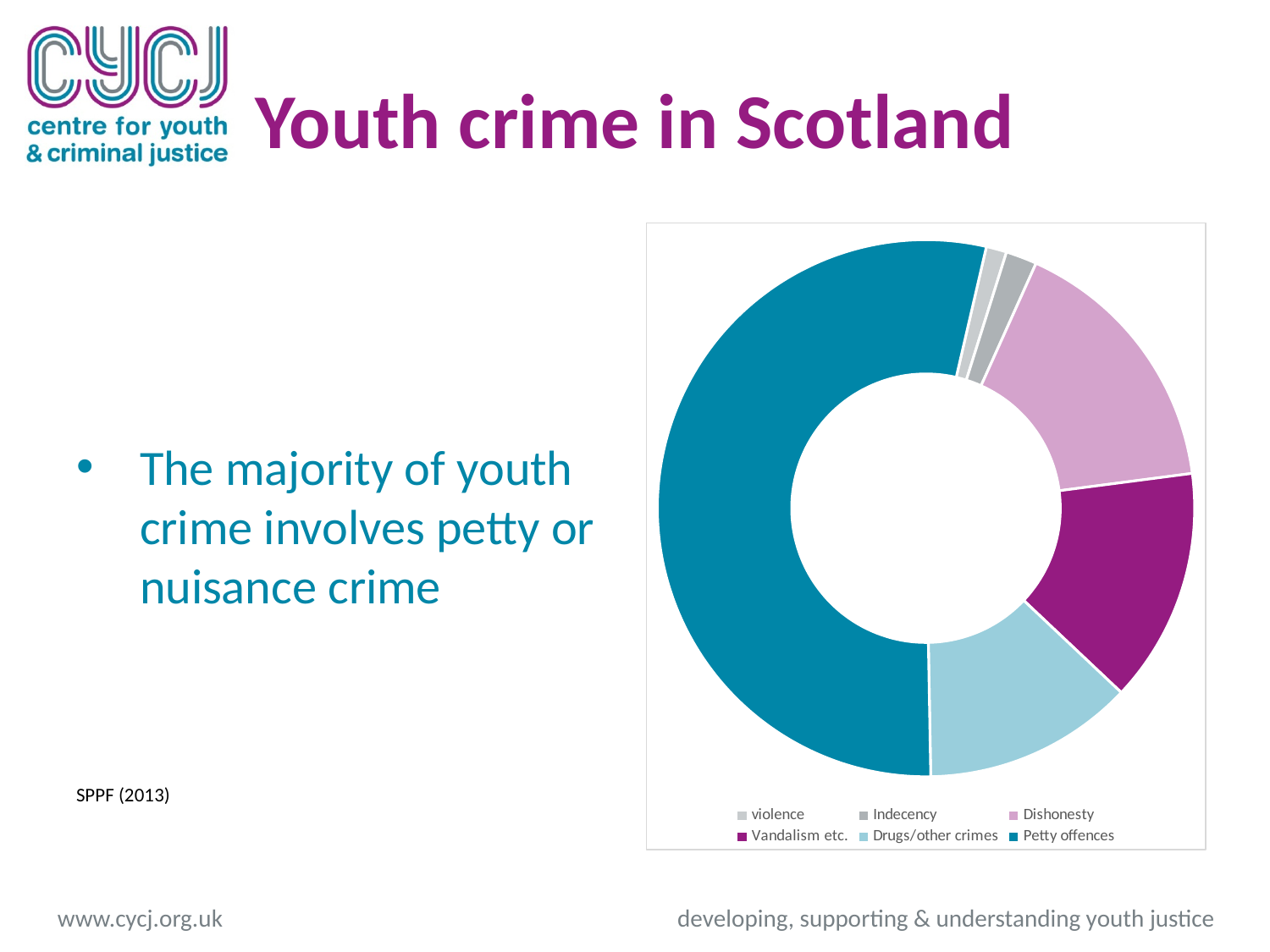
What kind of chart is shown on the slide? Doughnut (pie) chart What source is cited for the chart data on the slide? SPPF (2013) Which category takes up the largest share of the chart? Petty offences Is the Petty offences slice larger or smaller than all the other slices combined? larger Which is larger, the Petty offences slice or the Dishonesty slice? Petty offences Which is larger, the Drugs/other crimes slice or the violence slice? Drugs/other crimes What is the title of the slide containing the chart? Youth crime in Scotland How many categories does the chart's legend list? 6